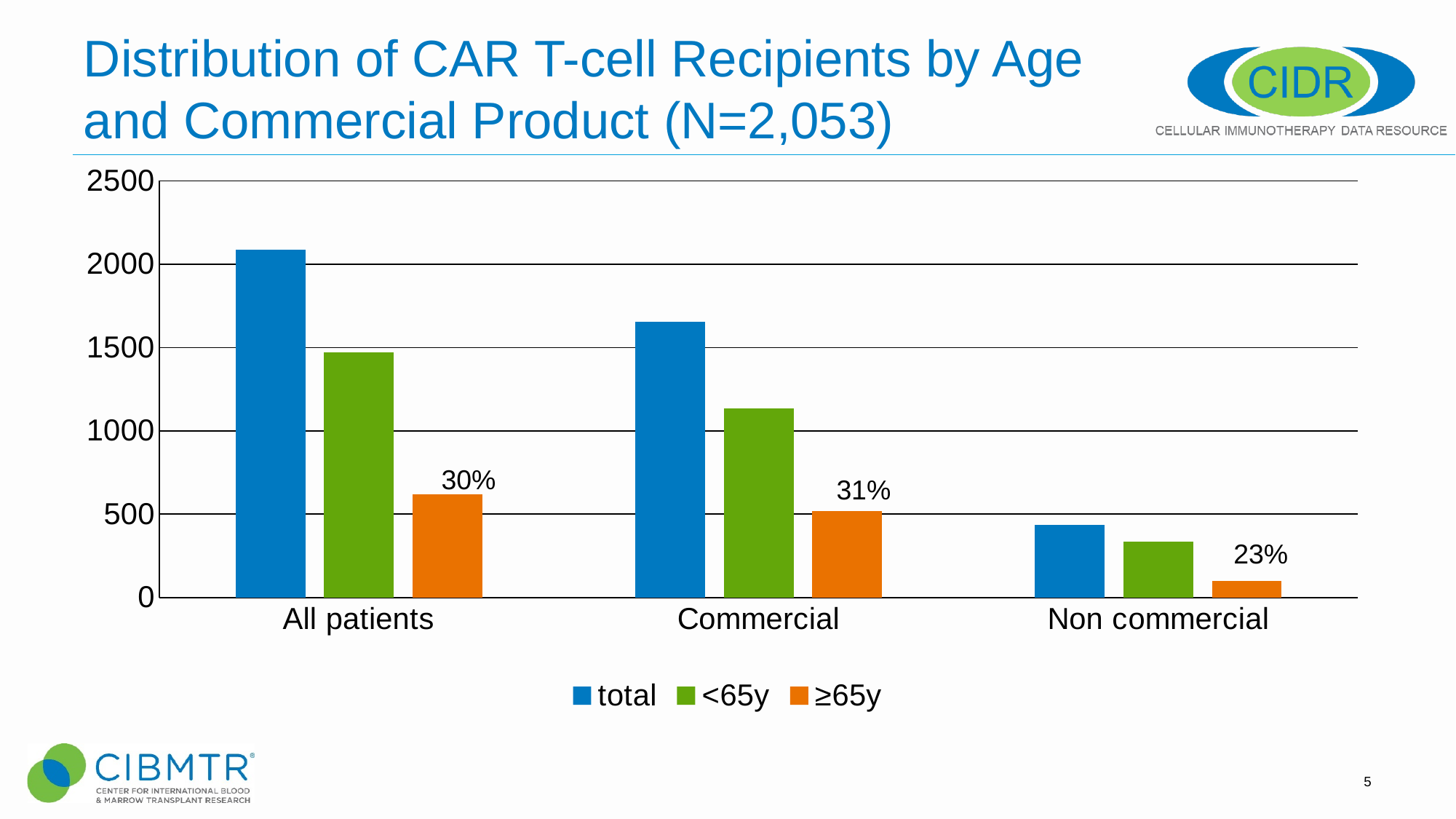
What percentage label is shown on the ≥65y bar for Commercial? 31% Is the total value for Non commercial greater or less than 500? less What percentage label is shown on the ≥65y bar for All patients? 30% Which category has the highest total bar? All patients What percentage label is shown on the ≥65y bar for Non commercial? 23% How many series does the legend list? 3 Is the total value for All patients greater or less than 2000? greater In the Commercial category, which is larger: the <65y bar or the ≥65y bar? <65y Which category has the lowest total bar? Non commercial What kind of chart is shown on the slide? bar chart How many categories are shown on the x axis? 3 Which colour represents the ≥65y series in the legend? orange